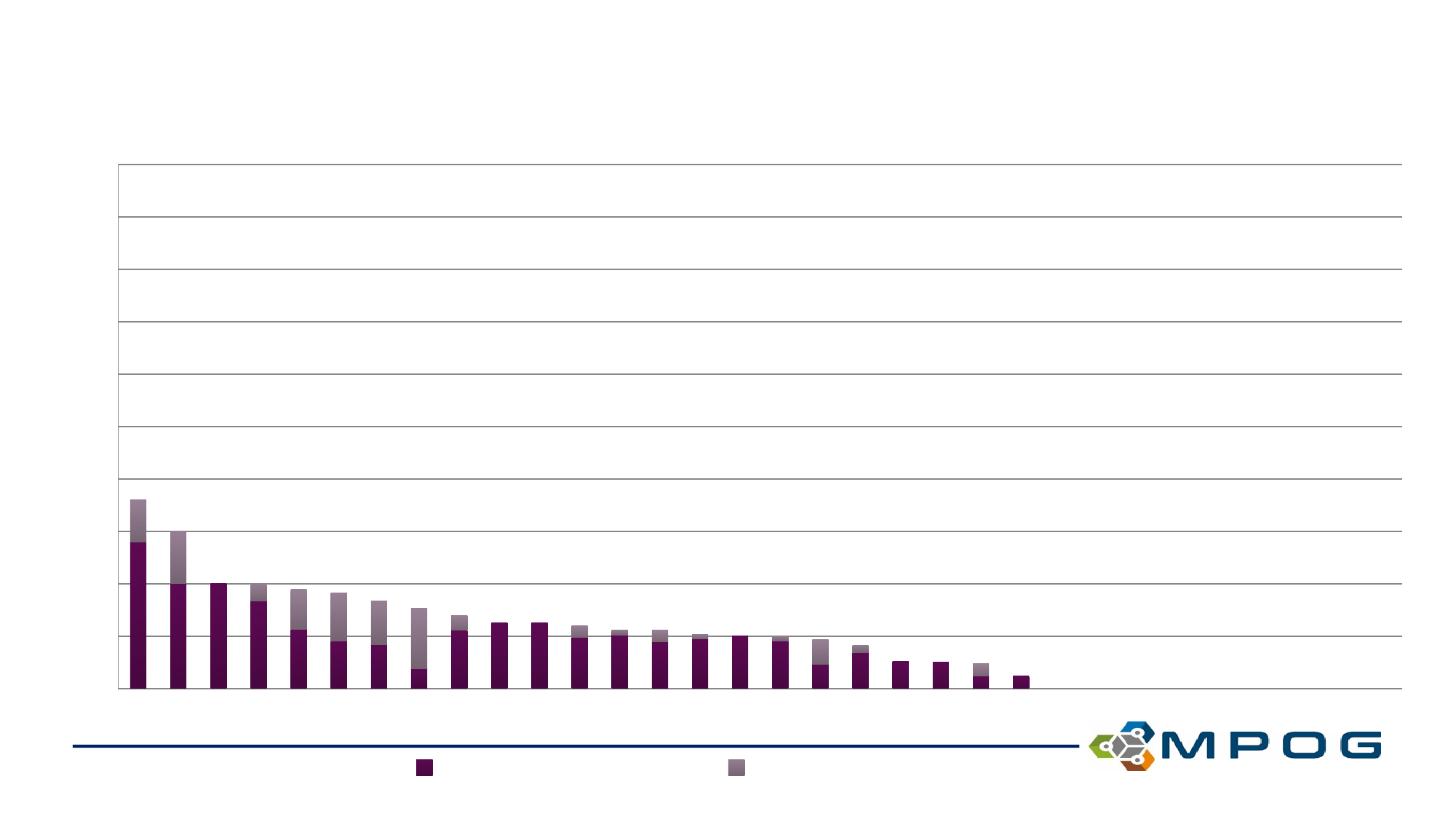
Are the bars in the chart stacked or side by side? stacked Do the bar heights rise or fall from left to right across the chart? fall Is the leftmost bar taller or shorter than the rightmost bar? taller What kind of chart is shown on the slide? bar chart How many bars are plotted in the chart? 23 Which bar is the shortest in the chart? the rightmost bar Which bar is the tallest in the chart? the leftmost bar How many series does the legend list? 2 What colour is the bottom segment of each stacked bar? dark purple